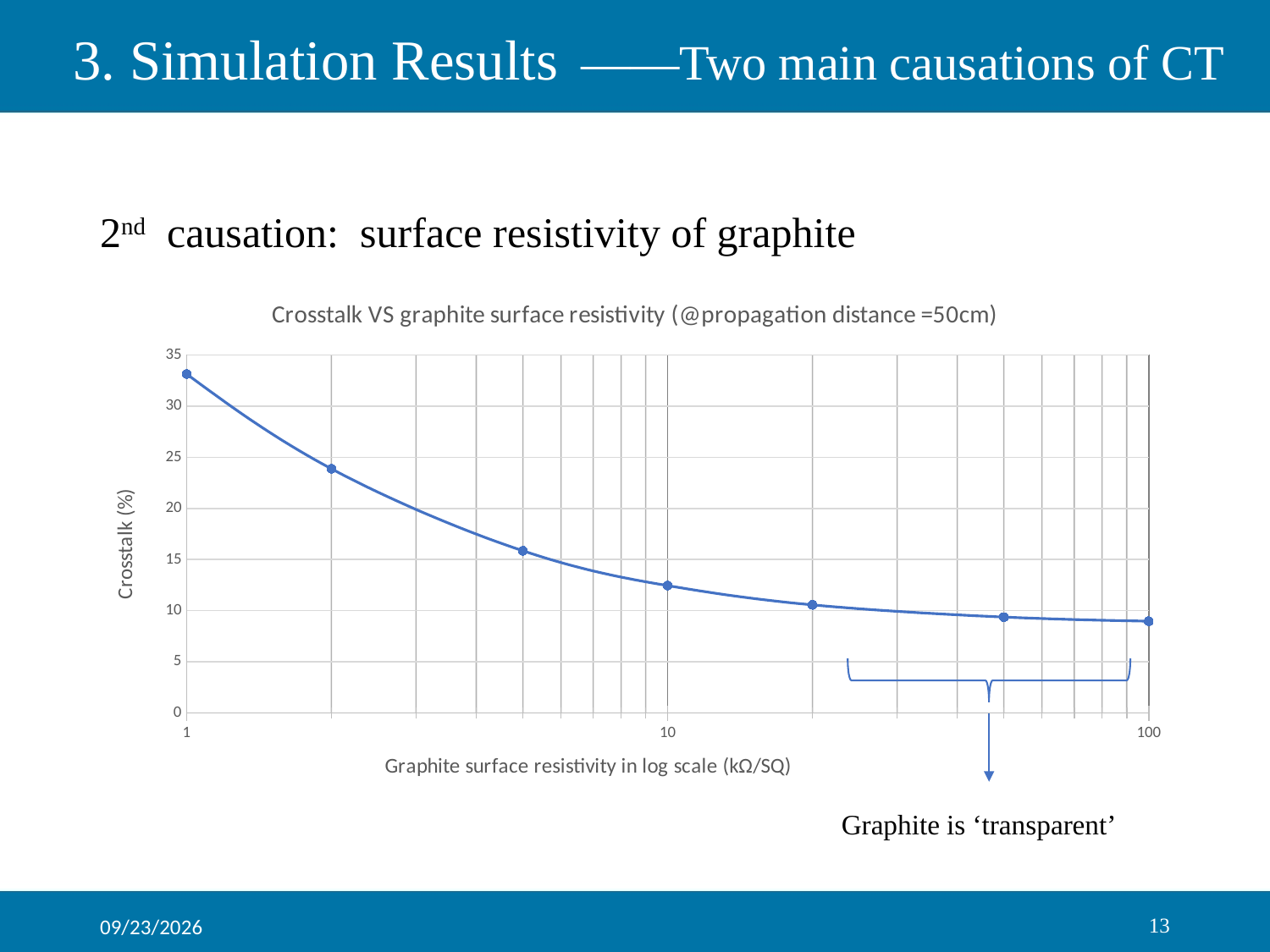
Is the crosstalk value at a graphite surface resistivity of 10 kΩ/SQ greater or less than 10? greater Is the crosstalk value at a graphite surface resistivity of 10 kΩ/SQ greater or less than 15? less What is the title of the chart? Crosstalk VS graphite surface resistivity (@propagation distance =50cm) Is the crosstalk value at a graphite surface resistivity of 1 kΩ/SQ greater or less than 30? greater At which graphite surface resistivity shown on the x axis is the crosstalk highest? 1 Which has the larger crosstalk value: the point at 10 kΩ/SQ or the point at 1 kΩ/SQ? 1 kΩ/SQ How many data points are plotted on the line? 7 What kind of chart is shown on the slide? line chart Which has the larger crosstalk value: the point at 1 kΩ/SQ or the point at 100 kΩ/SQ? 1 kΩ/SQ Does the crosstalk rise or fall as graphite surface resistivity increases along the x axis? fall What is the label of the y axis of the chart? Crosstalk (%)